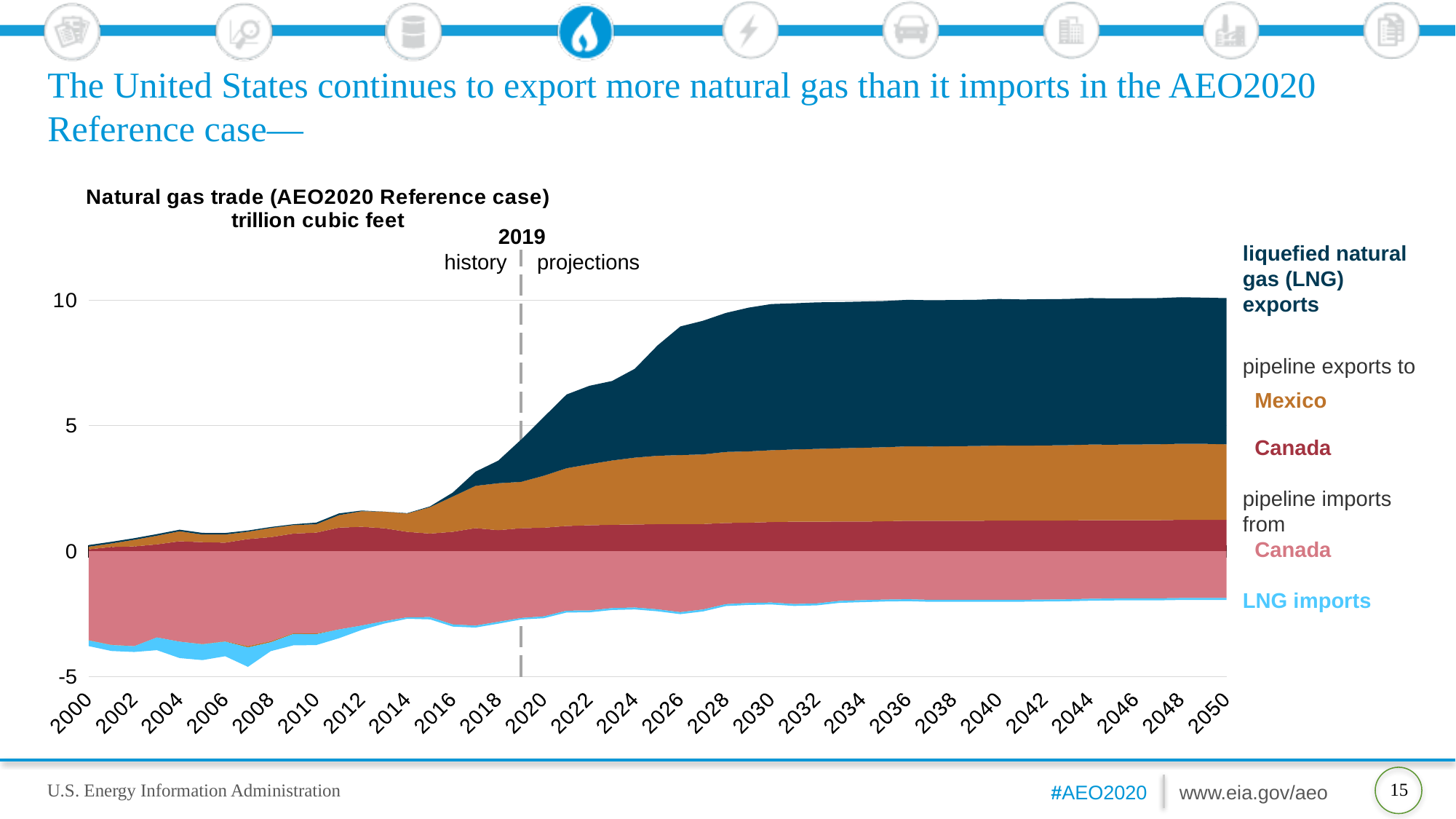
Which export series is the largest in 2050? liquefied natural gas (LNG) exports How many year labels are shown along the x axis? 26 What is the title of the chart? Natural gas trade (AEO2020 Reference case) Do total natural gas exports rise or fall from 2000 to 2050? rise Is the total of the export areas in 2000 greater or less than 5 trillion cubic feet? less Is the total of the export areas in 2030 greater or less than 5 trillion cubic feet? greater Which year marks the boundary between history and projections on the chart? 2019 What kind of chart is shown on the slide? Stacked area chart Is the total of the export areas in 2050 greater or less than 5 trillion cubic feet? greater How many series does the chart's legend list? 5 What unit is the chart's vertical axis measured in? trillion cubic feet Which export series is the smallest in 2050? pipeline exports to Canada